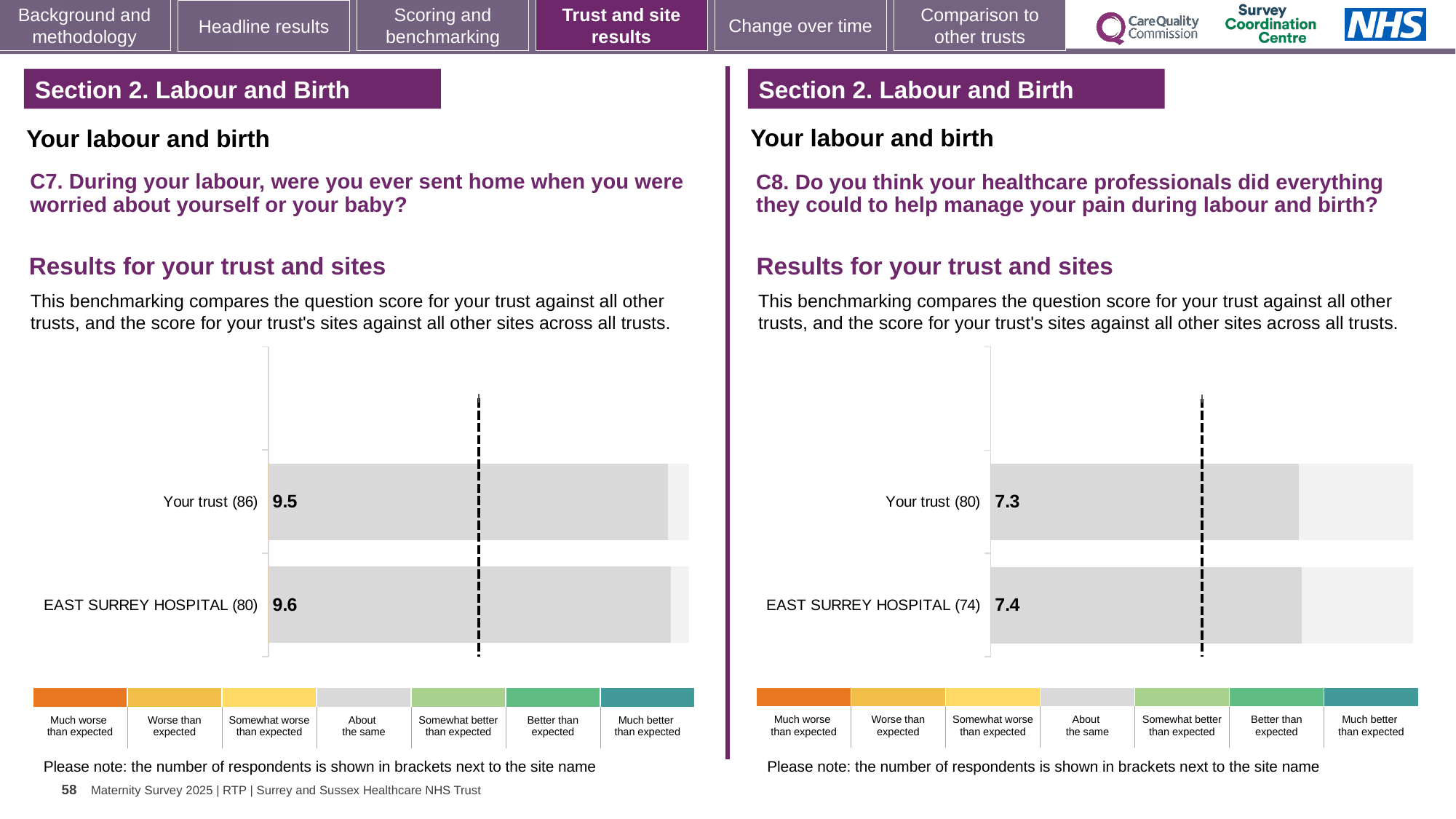
In the C7 chart on the left, how many respondents are shown in brackets for Your trust? 86 What kind of chart is used for the C8 results on the right? Bar chart How many bars are plotted in the C7 chart on the left? 2 In the C7 chart on the left, what is the difference between the EAST SURREY HOSPITAL score and the Your trust score? 0.1 In the C8 chart on the right, what is the difference between the EAST SURREY HOSPITAL score and the Your trust score? 0.1 In the C8 chart on the right, how many respondents are shown in brackets for EAST SURREY HOSPITAL? 74 In the C8 chart on the right, what is the score for Your trust? 7.3 In the C7 chart on the left, what is the score for EAST SURREY HOSPITAL? 9.6 In the C8 chart on the right, which has the lower score, Your trust or EAST SURREY HOSPITAL? Your trust In the C8 chart on the right, what is the score for EAST SURREY HOSPITAL? 7.4 In the C7 chart on the left, which has the higher score, Your trust or EAST SURREY HOSPITAL? EAST SURREY HOSPITAL In the C7 chart on the left, what is the score for Your trust? 9.5